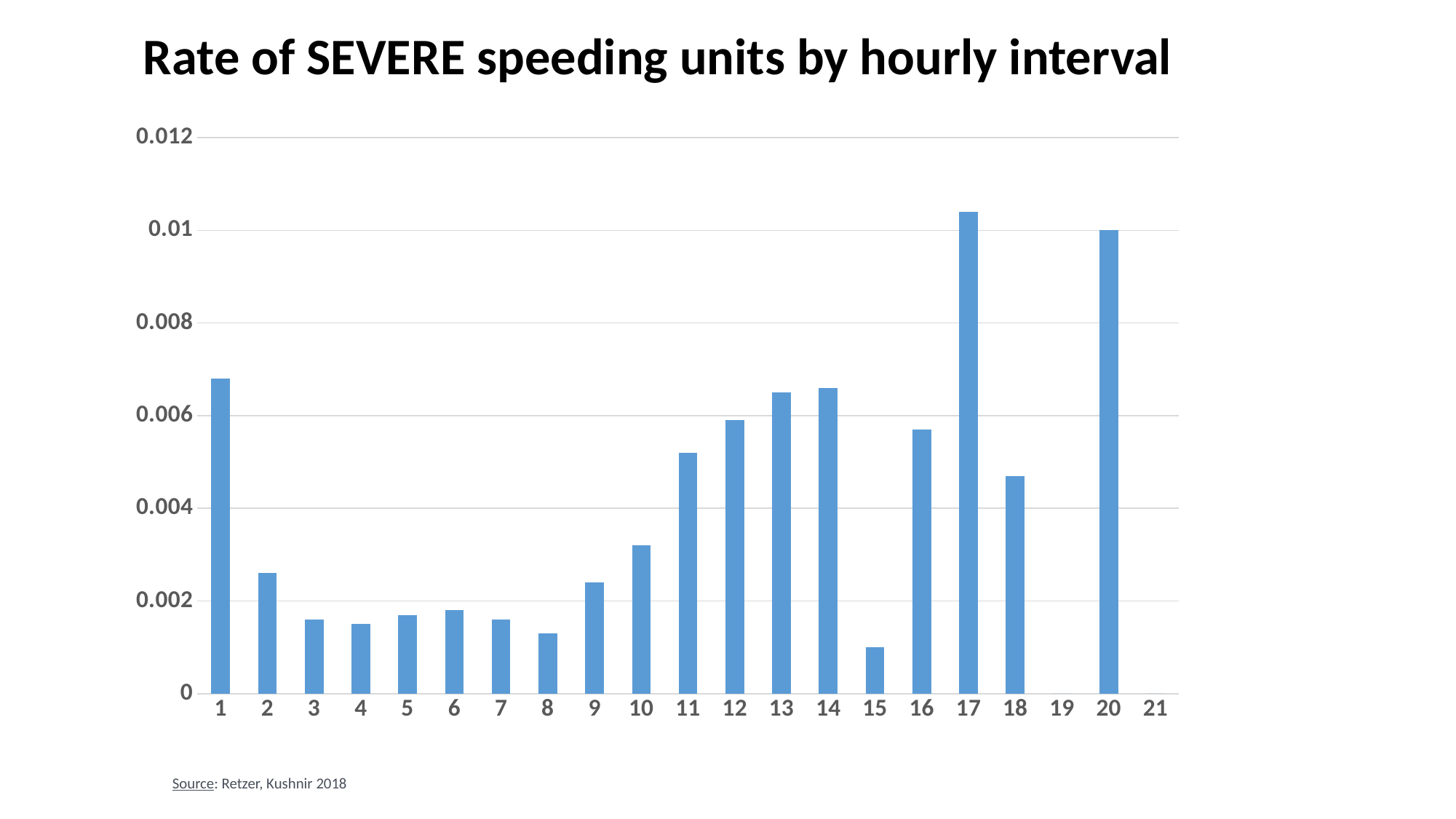
Is the value for interval 18 greater or less than 0.004? greater Is the value for interval 1 greater or less than 0.006? greater What kind of chart is shown on the slide? bar chart How many hourly intervals are labelled on the x axis? 21 What is the title of the chart? Rate of SEVERE speeding units by hourly interval Is the value for interval 15 greater or less than 0.002? less Which hourly interval has the highest rate? 17 Between intervals 8 and 14, do the values generally rise or fall? rise Which has the larger rate, interval 16 or interval 18? 16 What is the rate for hourly interval 20? 0.01 Which has the larger rate, interval 11 or interval 14? 14